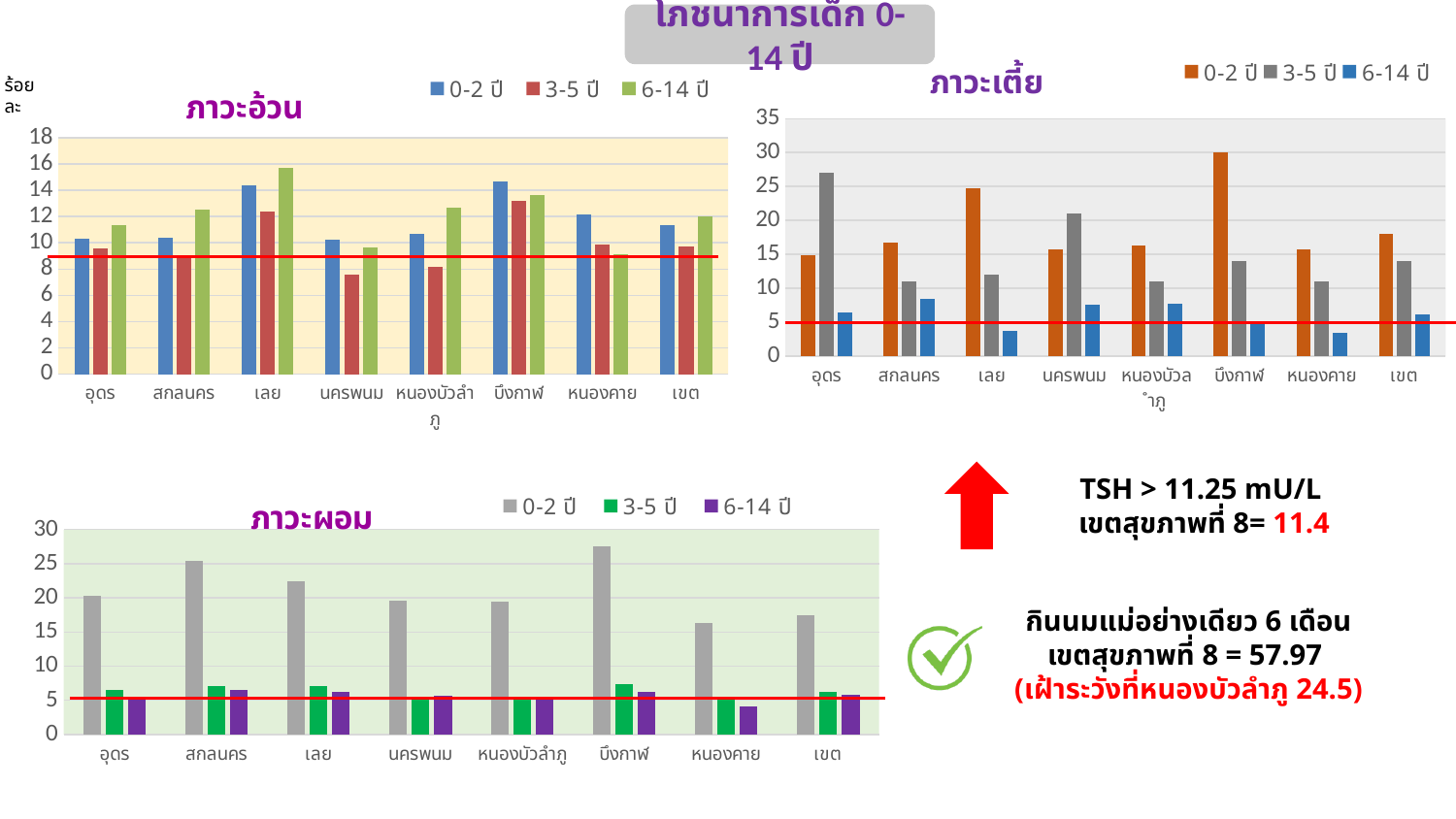
In the ภาวะเตี้ย chart, which category has the highest 0-2 ปี bar? บึงกาฬ In the ภาวะอ้วน chart, how many series does the legend list? 3 In the ภาวะผอม chart, which category has the highest 0-2 ปี bar? บึงกาฬ What kind of chart is the ภาวะผอม chart? bar chart In the ภาวะอ้วน chart, which category has the highest 6-14 ปี bar? เลย In the ภาวะอ้วน chart, which category has the lowest 3-5 ปี bar? นครพนม In the ภาวะอ้วน chart, how many provinces/categories are shown on the x axis? 8 In the ภาวะเตี้ย chart, is the 0-2 ปี value for เลย greater or less than 20? greater In the ภาวะผอม chart, which is larger for 0-2 ปี: สกลนคร or เลย? สกลนคร In the ภาวะอ้วน chart, is the 0-2 ปี value for บึงกาฬ greater or less than 12? greater In the ภาวะเตี้ย chart, is the 6-14 ปี value for อุดร greater or less than 10? less